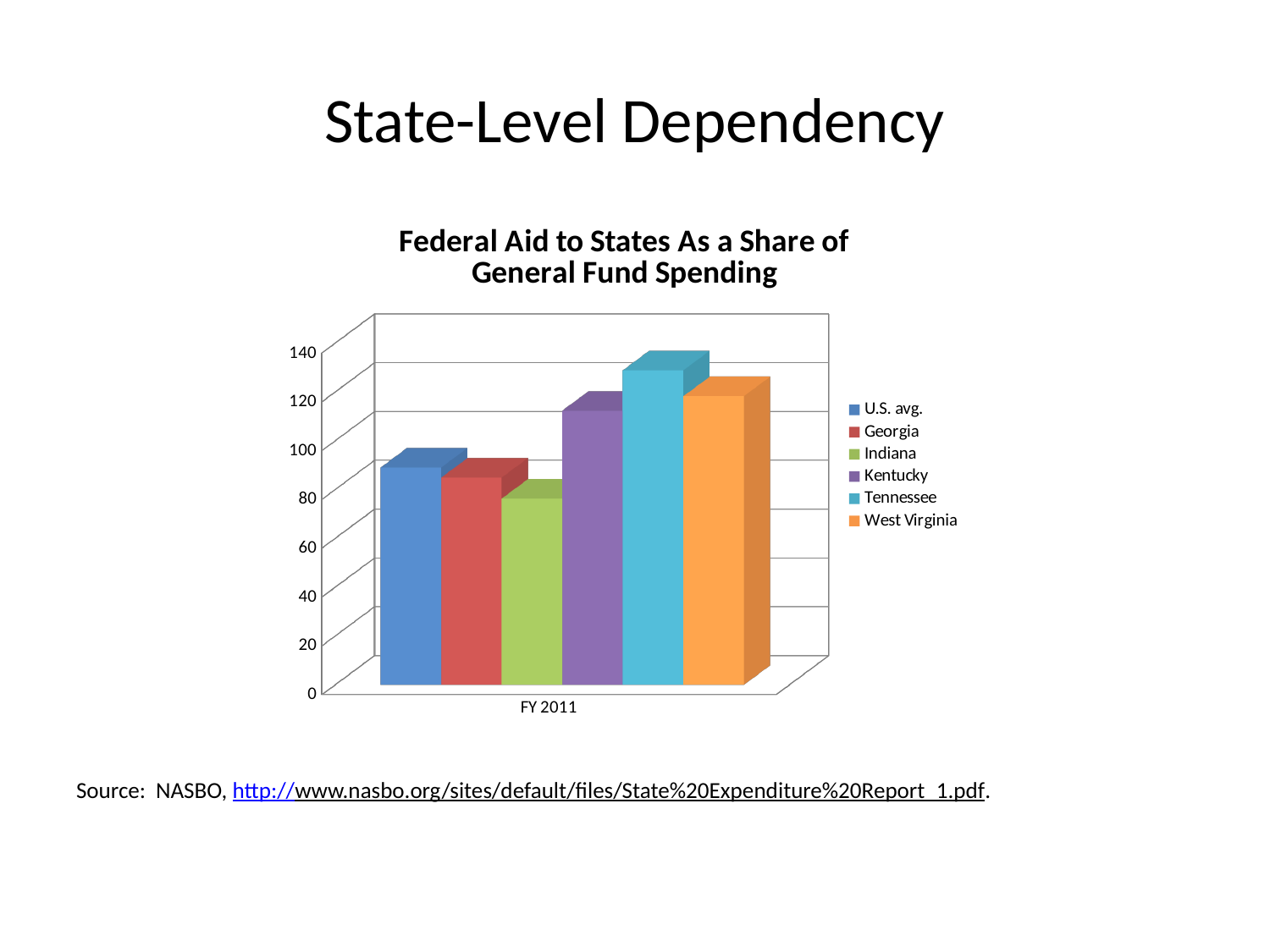
Which series has the lowest bar? Indiana What category label appears on the x axis? FY 2011 Is the value for U.S. avg. greater or less than 100? less What kind of chart is shown on the slide? bar chart Is the value for Tennessee greater or less than 120? greater How many series does the legend list? 6 Which series has the highest bar? Tennessee Is the value for Indiana greater or less than 100? less Which is larger, the value for Tennessee or the value for West Virginia? Tennessee Which is larger, the value for Kentucky or the value for Georgia? Kentucky What is the title of the chart? Federal Aid to States As a Share of General Fund Spending